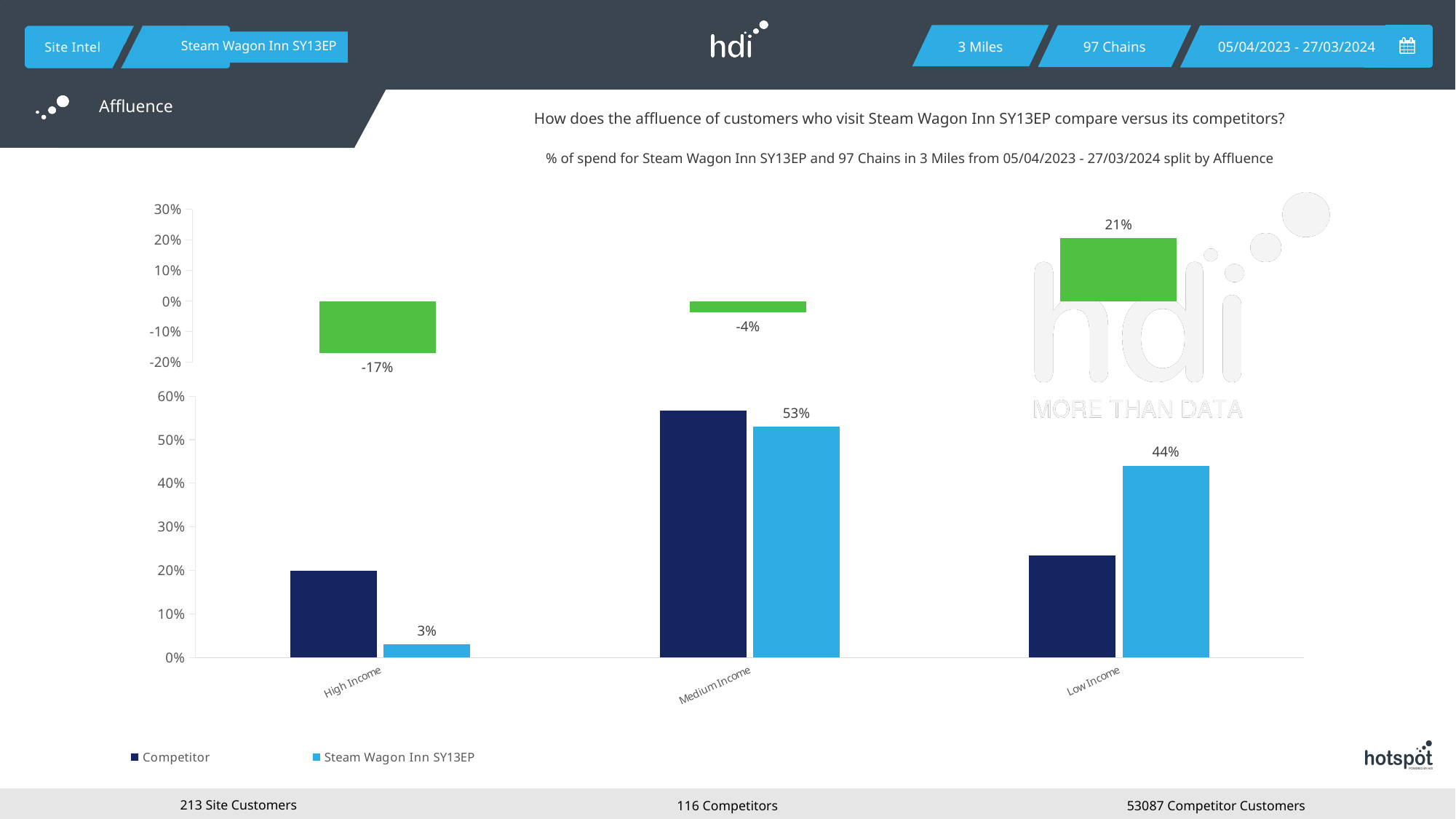
In the top chart, which category has the highest value? Low Income In the bottom chart, which category has the highest value for Steam Wagon Inn SY13EP? Medium Income In the top chart, what is the value shown for the Medium Income category? -4% How many series does the legend of the bottom chart list? 2 In the bottom chart, what is the value for Steam Wagon Inn SY13EP in the Low Income category? 44% In the bottom chart, is the Competitor value for Medium Income greater or less than 50%? greater In the bottom chart, what is the difference between the Steam Wagon Inn SY13EP values for Medium Income and Low Income? 9% In the bottom chart, what is the value for Steam Wagon Inn SY13EP in the High Income category? 3% In the bottom chart, is the Competitor value for Low Income greater or less than 30%? less In the top chart, which category has the lowest value? High Income What type of chart is the bottom chart? Bar chart In the bottom chart, which is larger for High Income: Competitor or Steam Wagon Inn SY13EP? Competitor